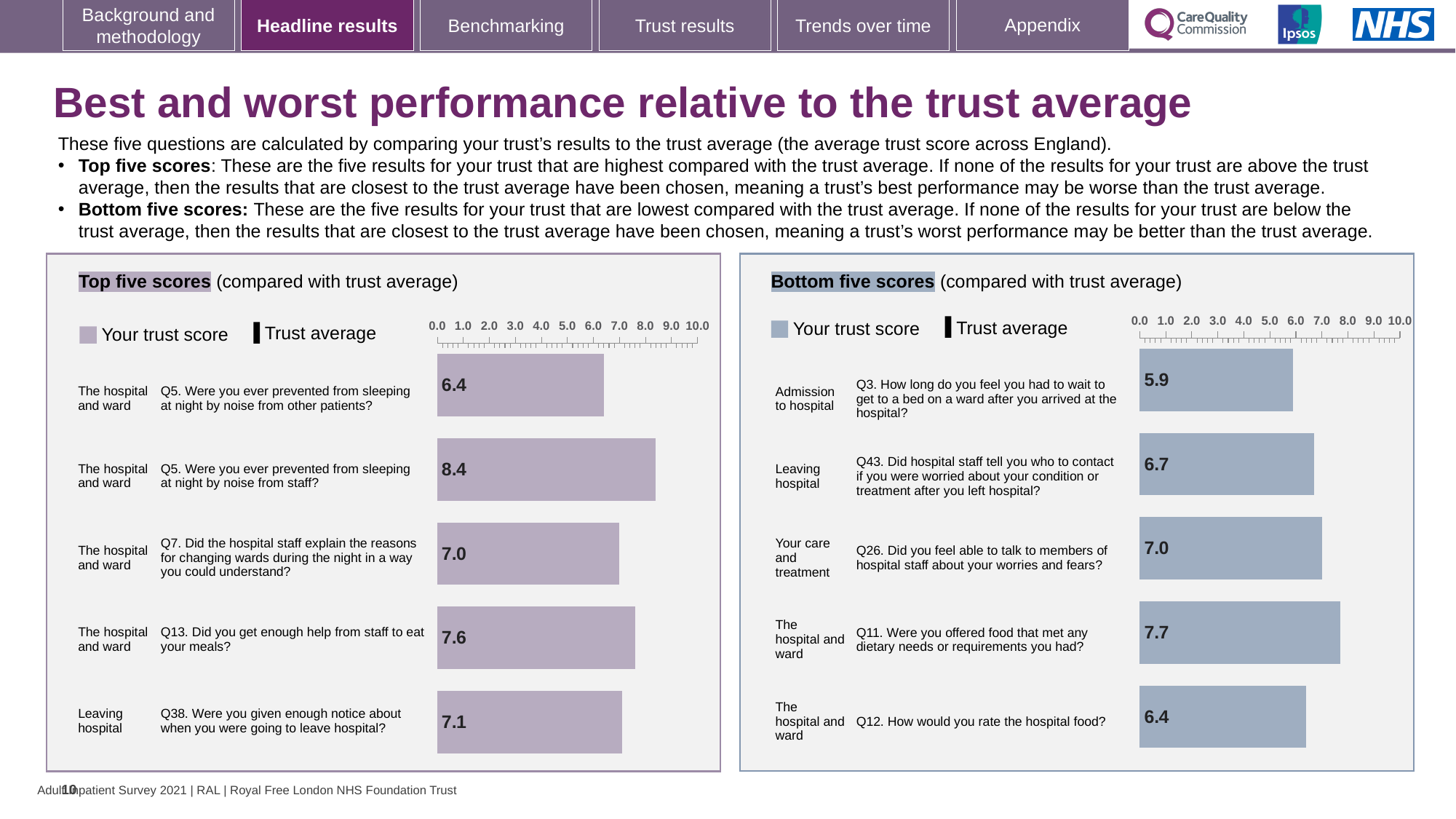
In the Bottom five scores chart, what is the trust score for Q3 (How long do you feel you had to wait to get to a bed on a ward after you arrived at the hospital?)? 5.9 In the Top five scores chart, what is the difference between the score for Q5 (noise from staff) and Q5 (noise from other patients)? 2.0 In the Bottom five scores chart, which has the larger trust score: Q11 or Q26? Q11 In the Top five scores chart, what is the trust score for Q13 (Did you get enough help from staff to eat your meals?)? 7.6 In the Bottom five scores chart, which question has the highest trust score? Q11. Were you offered food that met any dietary needs or requirements you had? In the Bottom five scores chart, which question has the lowest trust score? Q3. How long do you feel you had to wait to get to a bed on a ward after you arrived at the hospital? What type of chart is the Bottom five scores chart? Bar chart In the Bottom five scores chart, what is the difference between the score for Q11 and the score for Q3? 1.8 In the Bottom five scores chart, what is the trust score for Q12 (How would you rate the hospital food?)? 6.4 In the Top five scores chart, which question has the highest trust score? Q5. Were you ever prevented from sleeping at night by noise from staff? How many bars are plotted in the Top five scores chart? 5 What two entries does the legend of the Top five scores chart list? Your trust score and Trust average